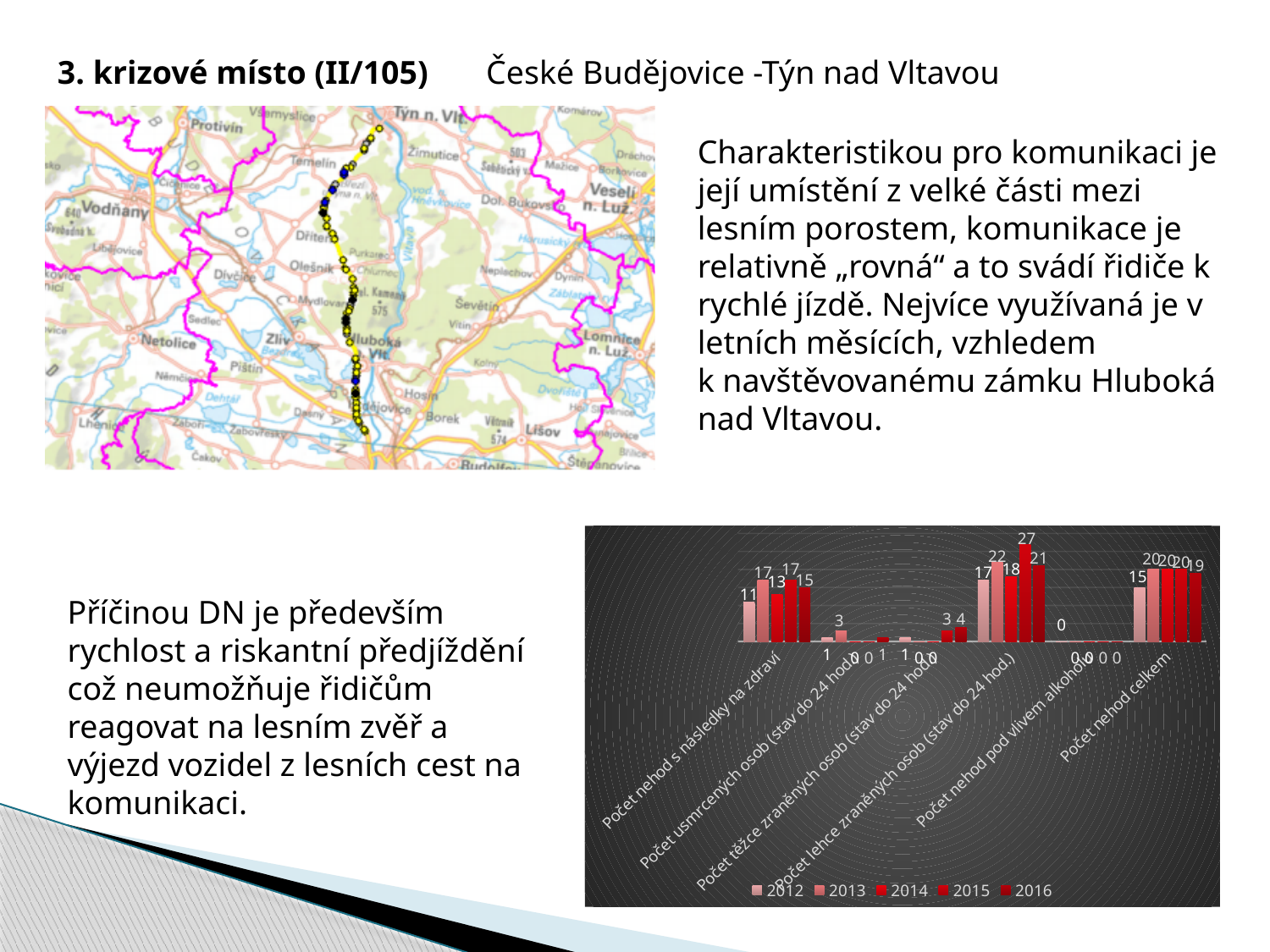
What is the value for 2015 in the category 'Počet lehce zraněných osob (stav do 24 hod)'? 27 How many categories are shown along the x axis of the chart? 6 Which year has the lowest value in the category 'Počet nehod s následky na zdraví'? 2012 Which year is listed first in the chart legend? 2012 In the category 'Počet nehod celkem', which is larger: the value for 2012 or the value for 2016? 2016 What is the value for 2012 in the category 'Počet nehod s následky na zdraví'? 11 Which year has the highest value in the category 'Počet lehce zraněných osob (stav do 24 hod)'? 2015 What is the difference between the 2015 and 2012 values in the category 'Počet lehce zraněných osob (stav do 24 hod)'? 10 What is the value for 2016 in the category 'Počet nehod celkem'? 19 How many series does the chart legend list? 5 What kind of chart is shown on the slide? bar chart What is the value for 2012 in the category 'Počet nehod celkem'? 15